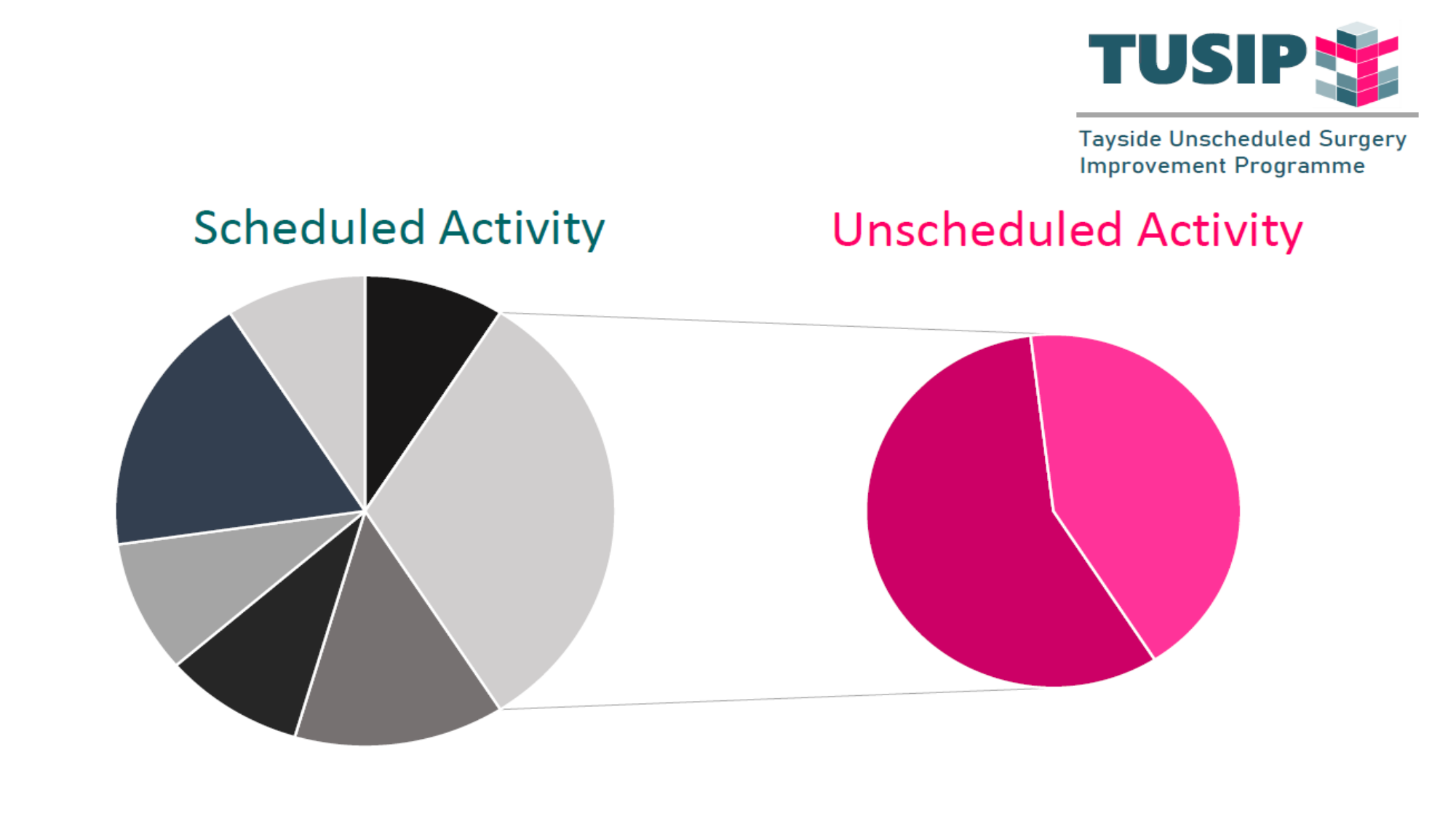
In the Scheduled Activity pie chart, what colour is the largest slice? light grey What is the title of the pie chart on the left of the slide? Scheduled Activity What is the title of the pie chart on the right of the slide? Unscheduled Activity In the Unscheduled Activity pie chart, is the dark magenta slice greater or less than half of the pie? greater What kind of chart is the Scheduled Activity chart? pie chart How many slices does the Unscheduled Activity pie chart have? 2 How many slices does the Scheduled Activity pie chart have? 7 How many pie charts are shown on the slide? 2 In the Unscheduled Activity pie chart, which slice is larger, the dark magenta slice or the bright pink slice? the dark magenta slice What kind of chart is the Unscheduled Activity chart? pie chart In the Scheduled Activity pie chart, is the largest light grey slice greater or less than half of the pie? less